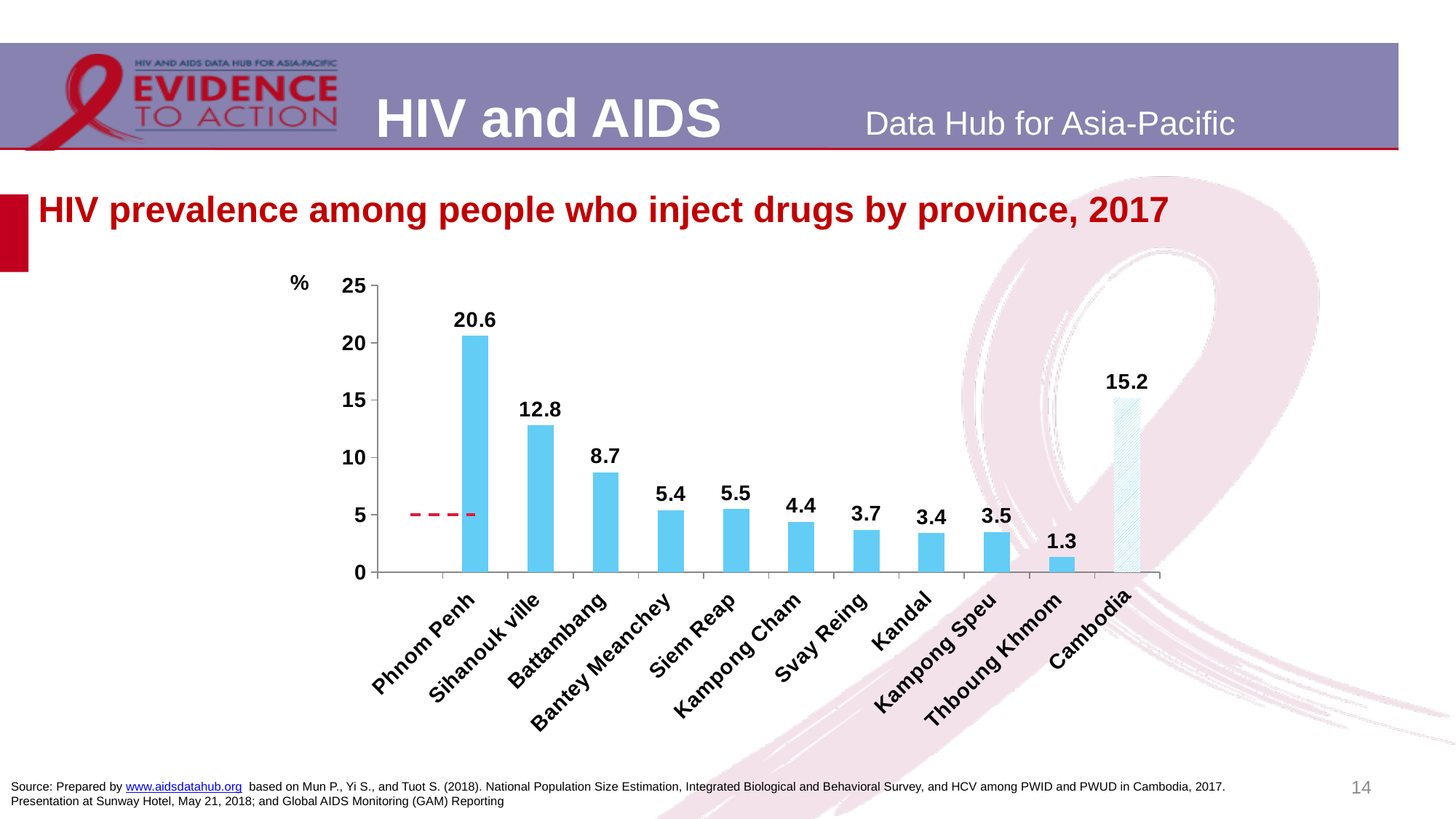
Is the value for Sihanouk ville greater or less than 10? greater What is the value shown for Battambang? 8.7 Which province has the lowest HIV prevalence among people who inject drugs? Thboung Khmom What unit is shown on the y axis of the chart? % How many categories are shown on the x axis of the chart? 11 Which province has the highest HIV prevalence among people who inject drugs? Phnom Penh What kind of chart is shown on the slide? Bar chart What is the difference between the values for Phnom Penh and Sihanouk ville? 7.8 What is the HIV prevalence among people who inject drugs in Phnom Penh? 20.6 Which has a higher value, Siem Reap or Kampong Cham? Siem Reap What is the value shown for Cambodia? 15.2 What is the title of the chart? HIV prevalence among people who inject drugs by province, 2017